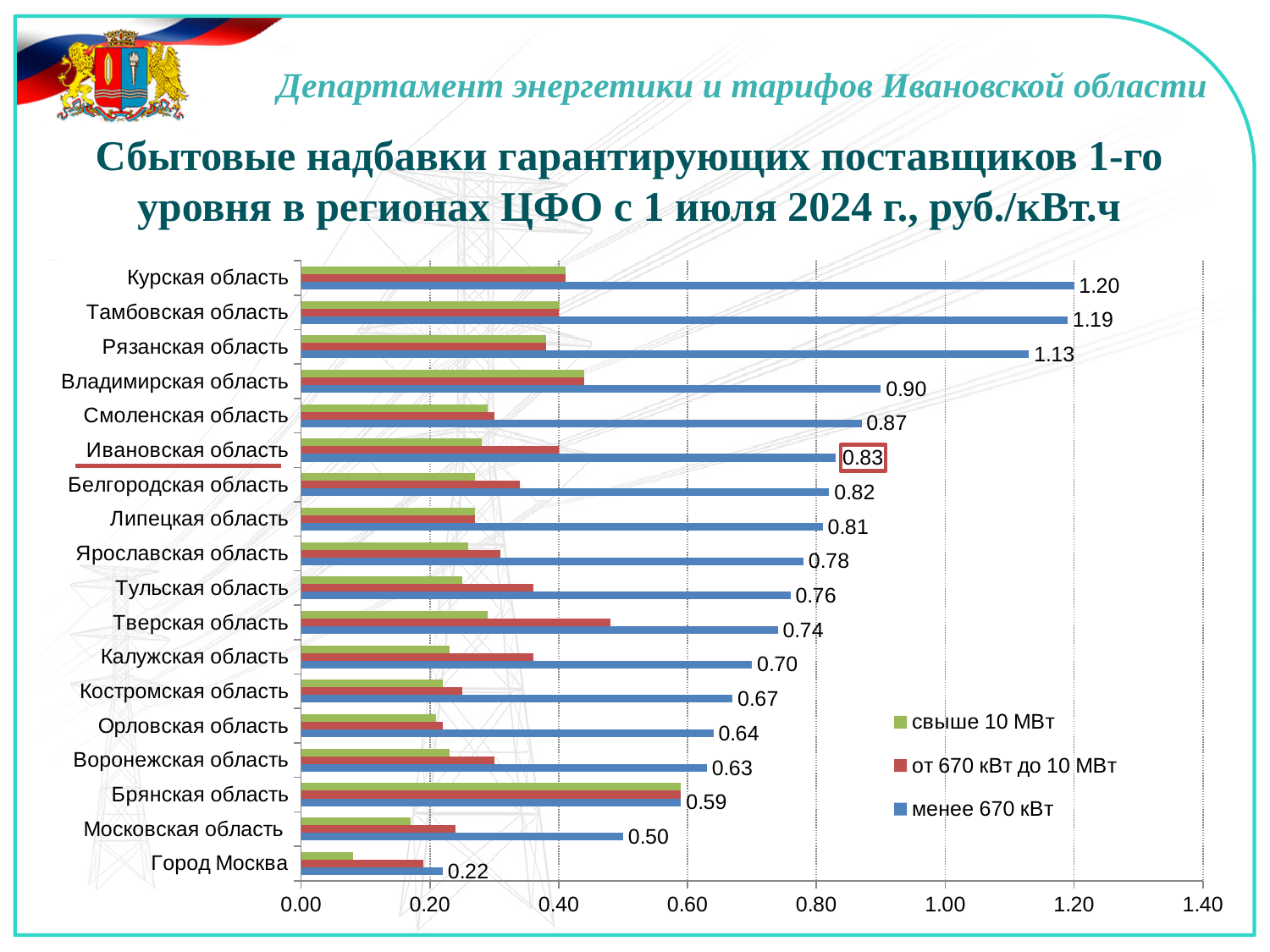
What is the value for Курская область in the series «менее 670 кВт»? 1.20 Which region has the lowest value in the series «менее 670 кВт»? Город Москва Is the value for Город Москва in the series «свыше 10 МВт» greater or less than 0.20? less What is the difference between the «менее 670 кВт» values for Курская область and Город Москва? 0.98 Which region has the highest value in the series «менее 670 кВт»? Курская область How many series does the legend list? 3 How many regions are shown on the chart? 18 What kind of chart is shown on the slide? bar chart Is the value for Брянская область in the series «свыше 10 МВт» greater or less than 0.40? greater Which region's label is underlined in red on the chart? Ивановская область What is the value for Ивановская область in the series «менее 670 кВт»? 0.83 Which is larger in the series «менее 670 кВт»: Смоленская область or Белгородская область? Смоленская область